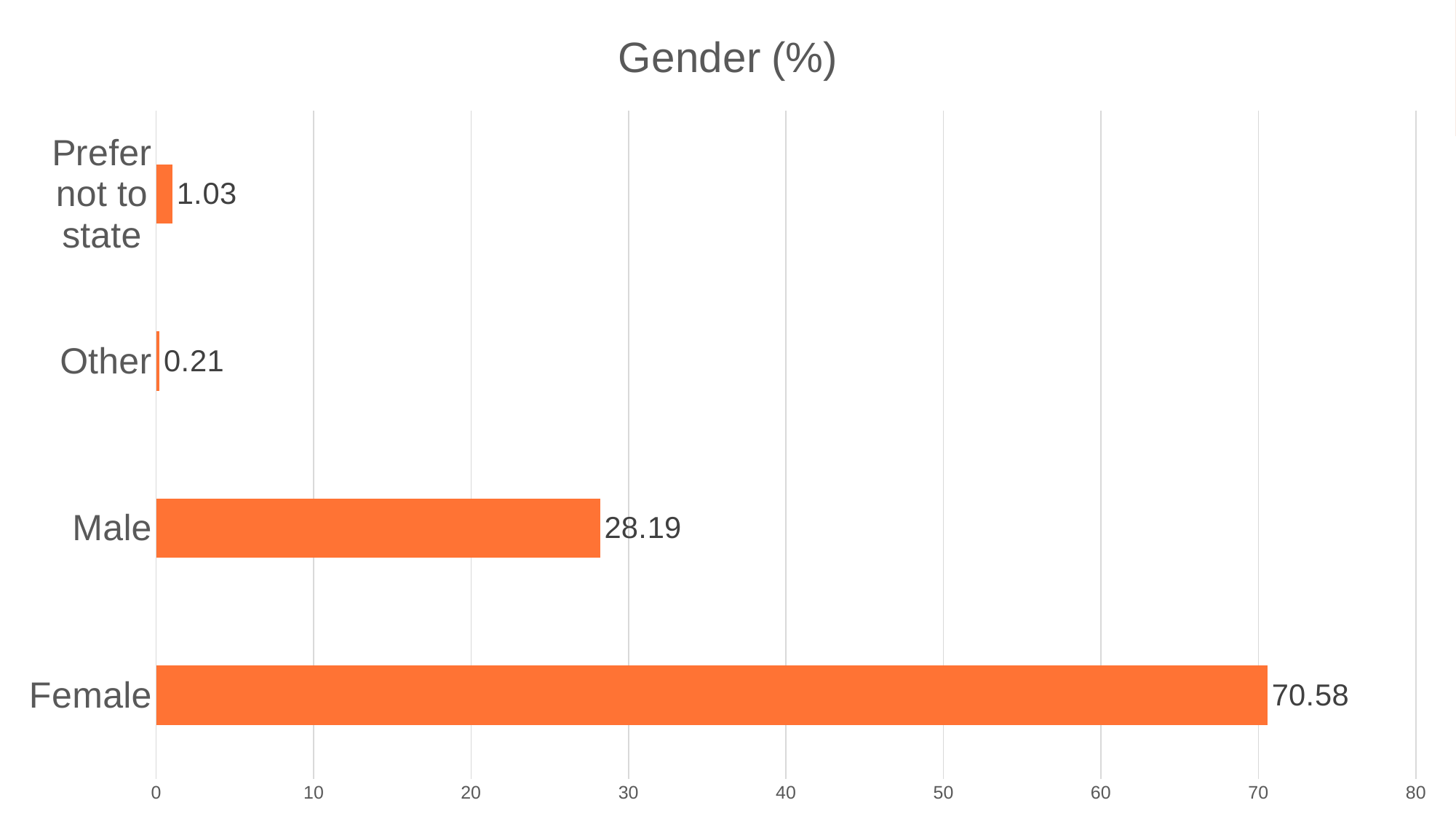
Which category has the lowest value? Other Which category has the highest value? Female What is the title of the chart? Gender (%) What is the value for Female? 70.58 What is the value for Other? 0.21 Is the value for Female greater or less than 60? greater What is the value for Prefer not to state? 1.03 What is the value for Male? 28.19 Which is larger, the value for Male or the value for Prefer not to state? Male What is the difference between the values for Female and Male? 42.39 How many categories are shown in the chart? 4 What kind of chart is shown on the slide? Bar chart